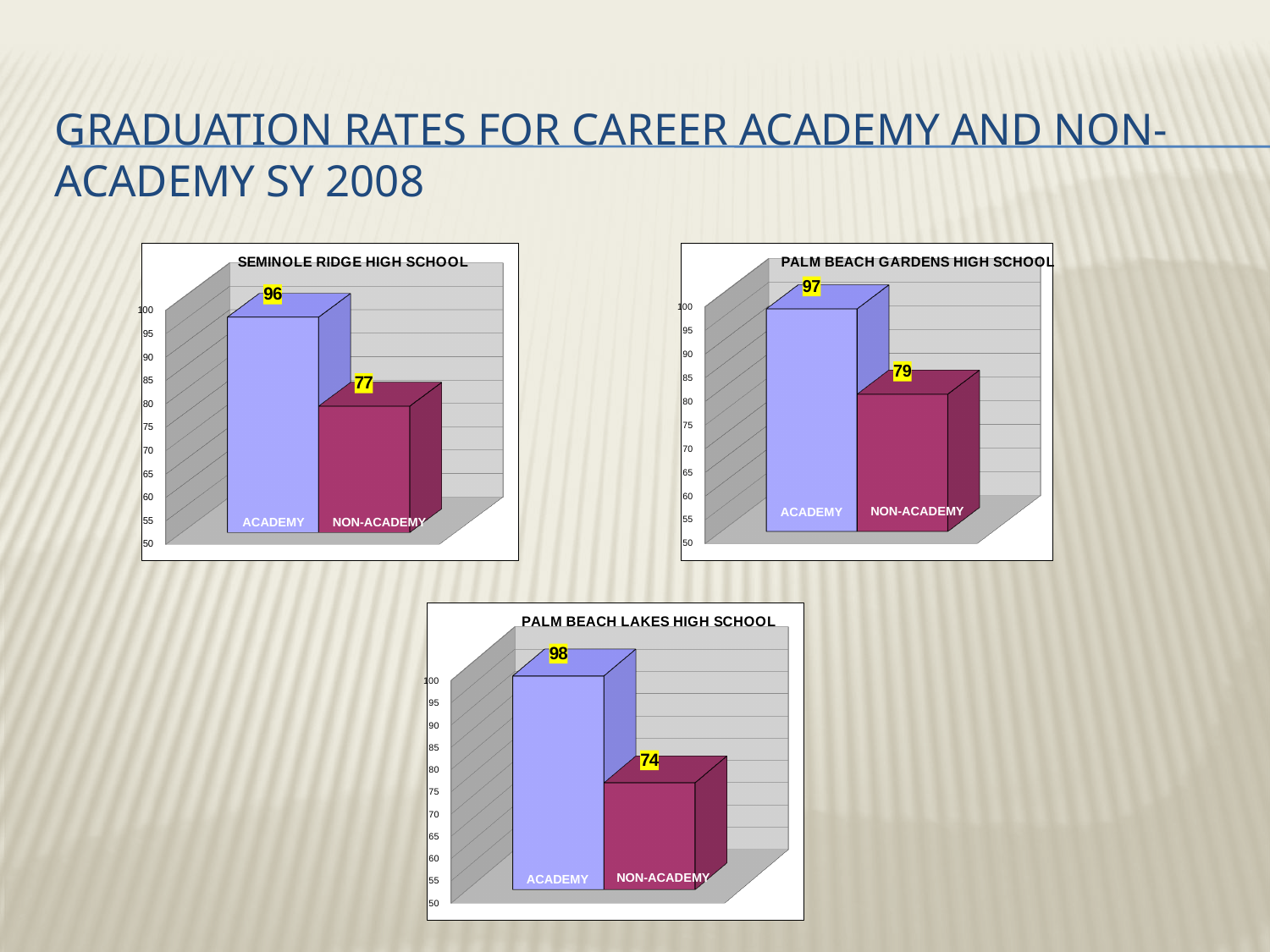
How many charts are shown on the slide? 3 In the Palm Beach Gardens High School chart, is the value for ACADEMY larger or smaller than the value for NON-ACADEMY? larger In the Seminole Ridge High School chart, what is the value for NON-ACADEMY? 77 In the Seminole Ridge High School chart, what is the value for ACADEMY? 96 In the Palm Beach Lakes High School chart, what is the value for ACADEMY? 98 In the Palm Beach Lakes High School chart, what is the difference between the ACADEMY and NON-ACADEMY values? 24 How many bars are shown in the Seminole Ridge High School chart? 2 In the Palm Beach Lakes High School chart, which category has the lowest value? NON-ACADEMY In the Palm Beach Gardens High School chart, what is the value for NON-ACADEMY? 79 In the Seminole Ridge High School chart, which category has the higher value? ACADEMY What kind of chart is the Palm Beach Lakes High School chart? bar chart In the Palm Beach Gardens High School chart, what is the difference between the ACADEMY and NON-ACADEMY values? 18